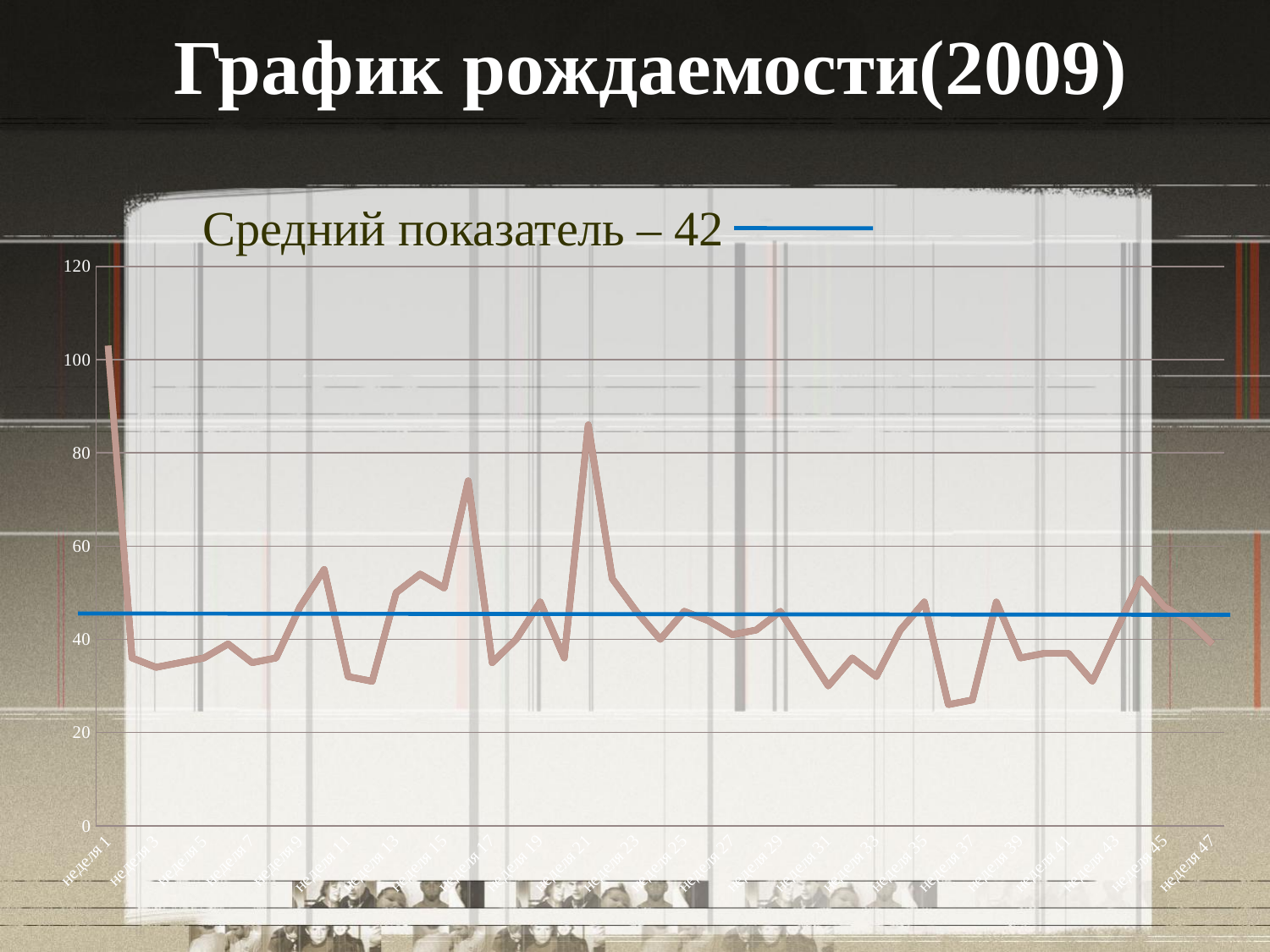
Is the value for неделя 3 greater or less than 40? less What kind of chart is shown on the slide? line chart Is the value for неделя 1 greater or less than 80? greater Is the value for неделя 11 greater or less than 40? less What is the title of the chart on the slide? График рождаемости(2009) Does the value rise or fall from неделя 1 to неделя 3? fall What average value (средний показатель) is stated on the slide? 42 Which week has the highest value on the chart? неделя 1 Which is larger, the value for неделя 15 or the value for неделя 21? неделя 21 Which is larger, the value for неделя 1 or the value for неделя 21? неделя 1